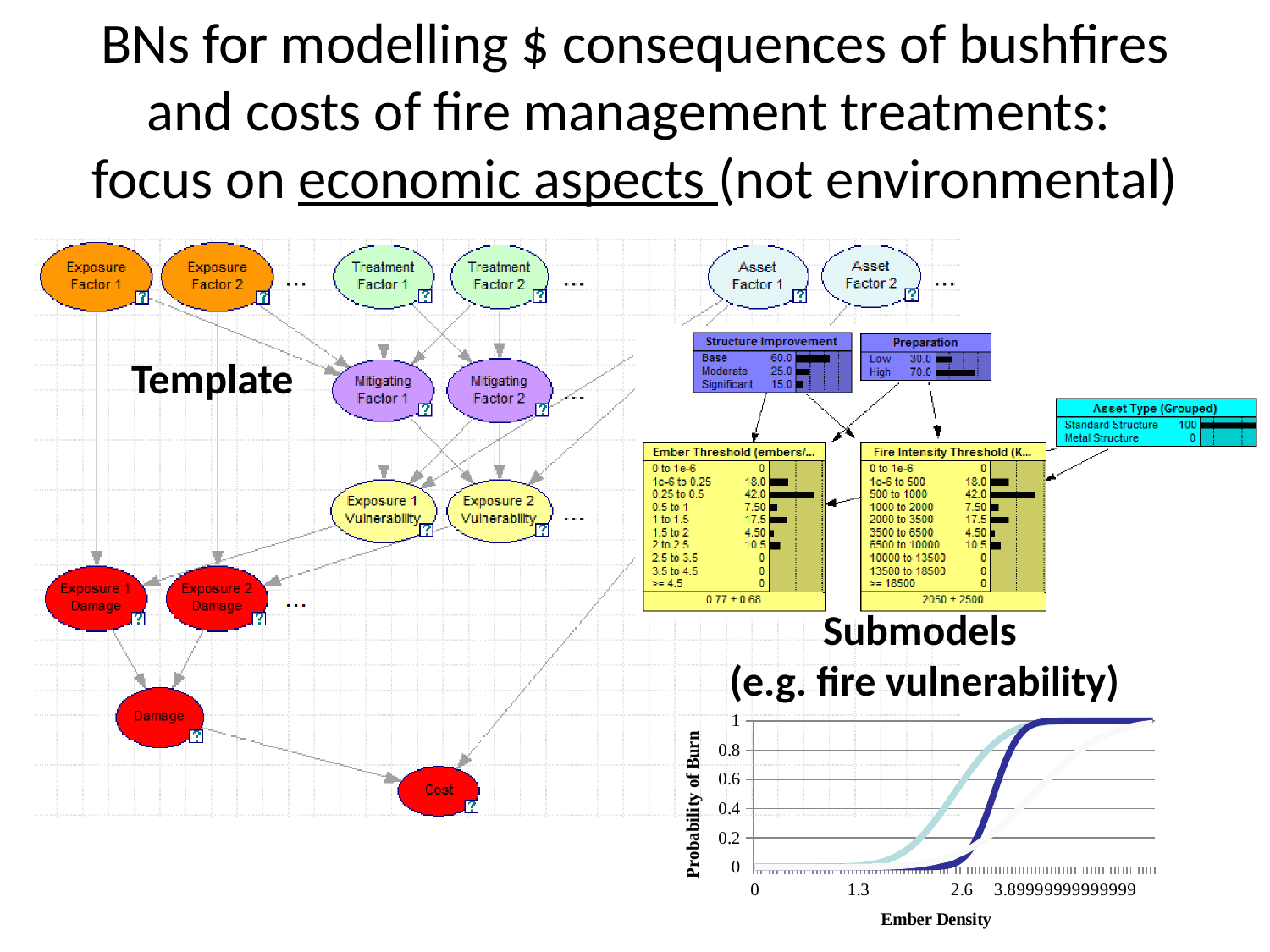
In the Structure Improvement node, which state has the lowest value? Significant In the bottom-right chart, what is the highest tick value shown on the y axis? 1 In the Structure Improvement node, what is the value for Base? 60.0 In the bottom-right chart, is the value of the dark blue curve at Ember Density 1.3 greater or less than 0.2? less In the Preparation node, what is the difference between the High and Low values? 40.0 In the bottom-right chart, what is the label of the y axis? Probability of Burn What kind of chart is the Probability of Burn vs Ember Density chart at the bottom right of the slide? line chart In the Asset Type (Grouped) node, what is the value for Standard Structure? 100 In the bottom-right chart, what is the label of the x axis? Ember Density In the Preparation node, what is the value for High? 70.0 In the bottom-right chart, do the curves rise or fall as Ember Density increases? rise